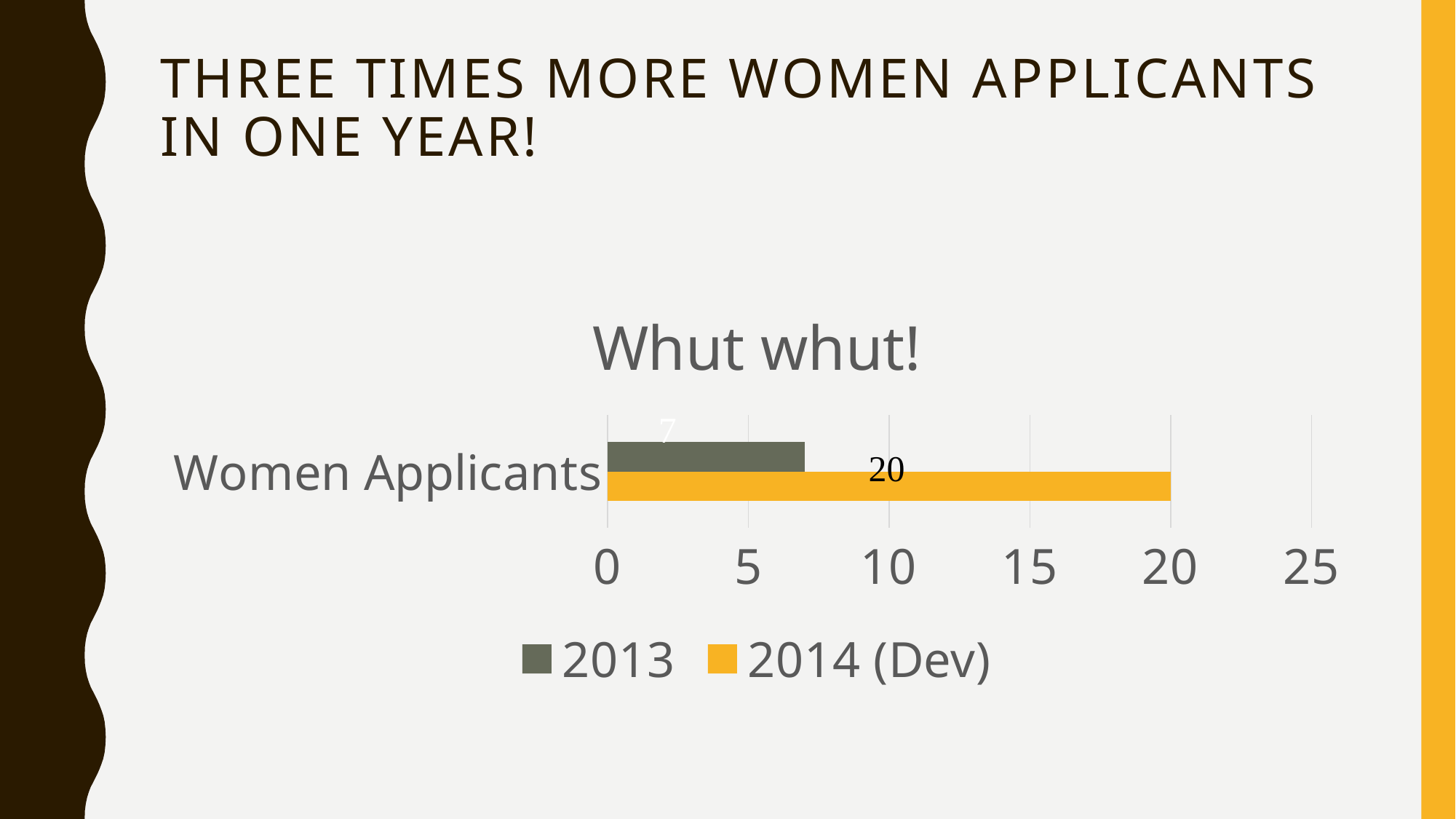
Which series has the higher value for Women Applicants, 2013 or 2014 (Dev)? 2014 (Dev) Is the value for 2013 greater or less than 10? less How many categories are shown on the chart? 1 What is the highest value shown on the x axis? 25 What is the value for 2014 (Dev) for Women Applicants? 20 Is the value for 2014 (Dev) greater or less than 15? greater What is the difference between the 2014 (Dev) and 2013 values for Women Applicants? 13 Which series is shown in yellow in the legend? 2014 (Dev) How many series does the legend list? 2 What is the title of the chart? Whut whut! What is the value for 2013 for Women Applicants? 7 What kind of chart is shown on the slide? bar chart